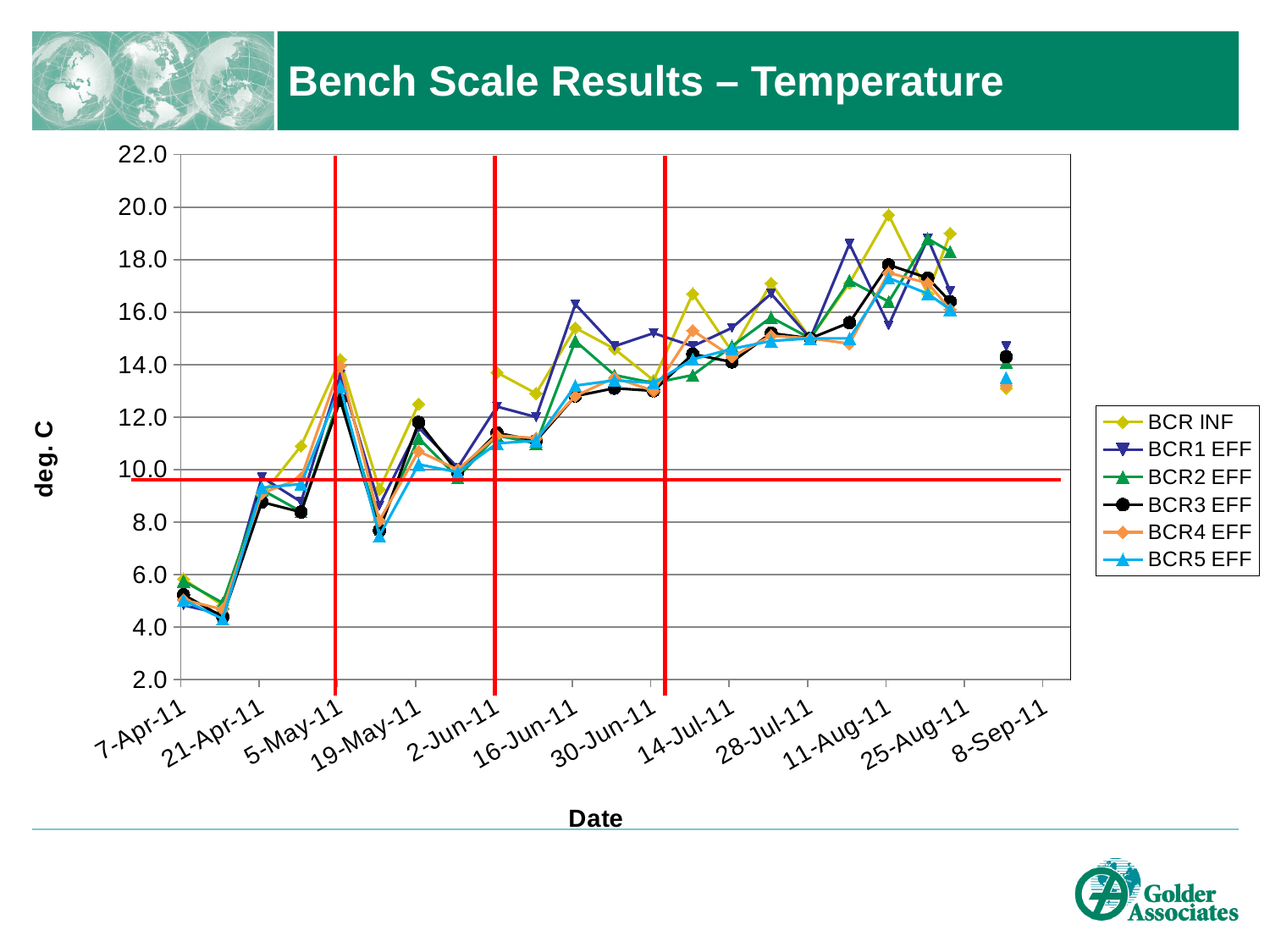
Near 11-Aug-11, which is larger, BCR INF or BCR1 EFF? BCR INF What kind of chart is shown on the slide? line chart Is the peak value for BCR INF near 11-Aug-11 greater or less than 18.0? greater Which series reaches the highest value on the chart? BCR INF Do the temperature values generally rise or fall from April to August along the x axis? rise What is the label on the y axis? deg. C Are the values for all series at 21-Apr-11 greater or less than 8.0? greater How many date labels are shown along the x axis? 12 Is the value for BCR3 EFF at 19-May-11 greater or less than 10.0? greater How many vertical red lines are drawn on the chart? 3 How many series does the legend list? 6